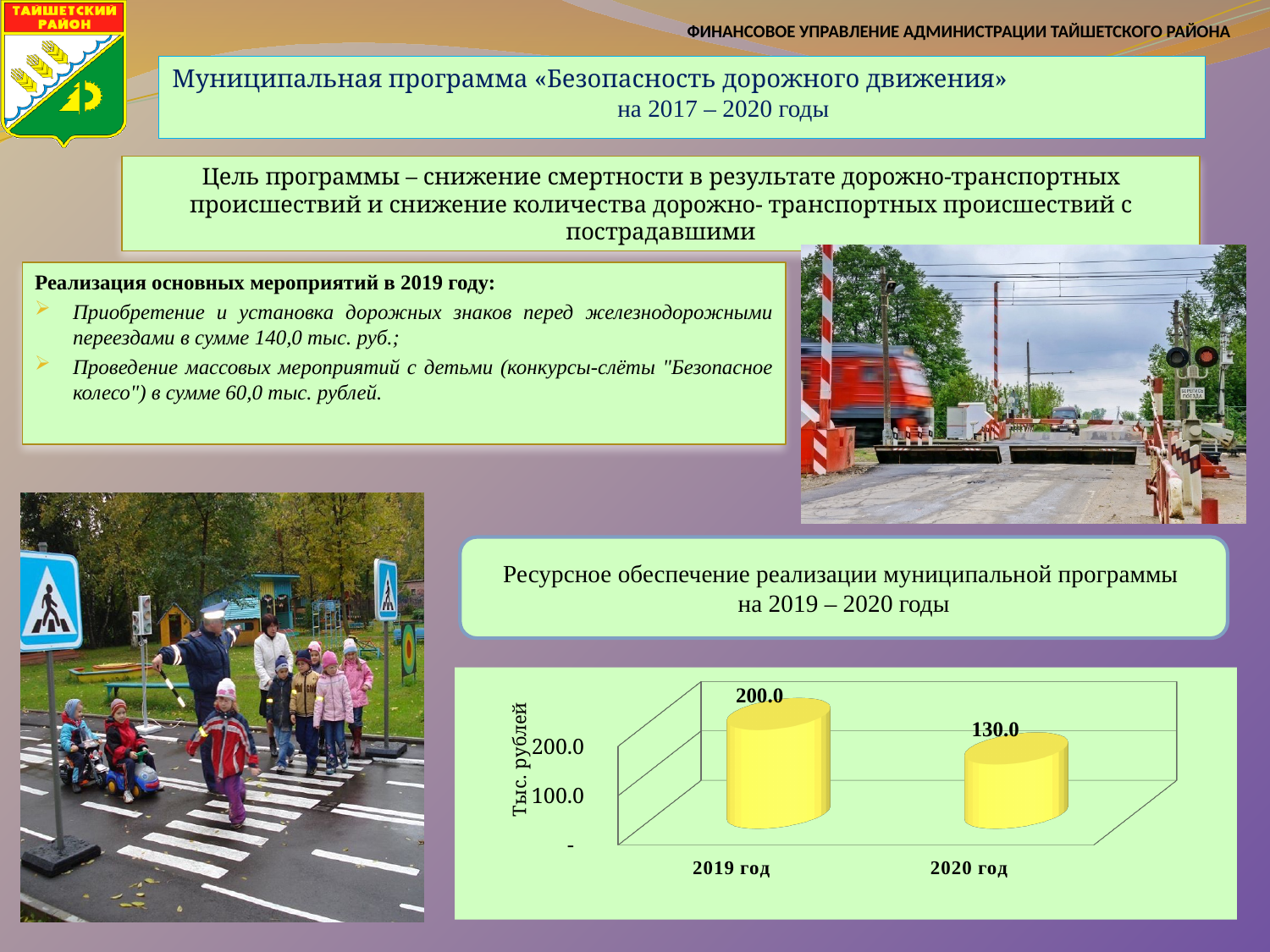
What is the label of the vertical axis of the chart? Тыс. рублей What kind of chart is shown on the slide? bar chart How many categories are shown on the x axis of the chart? 2 Which is larger, the value for 2019 год or for 2020 год? 2019 год Which year has the highest value in the chart? 2019 год What is the difference between the values for 2019 год and 2020 год? 70.0 Is the value for 2020 год greater or less than 100.0? greater Do the values rise or fall from 2019 год to 2020 год? fall What is the value for 2019 год in the chart? 200.0 What colour are the bars in the chart? yellow What is the value for 2020 год in the chart? 130.0 Which year has the lowest value in the chart? 2020 год